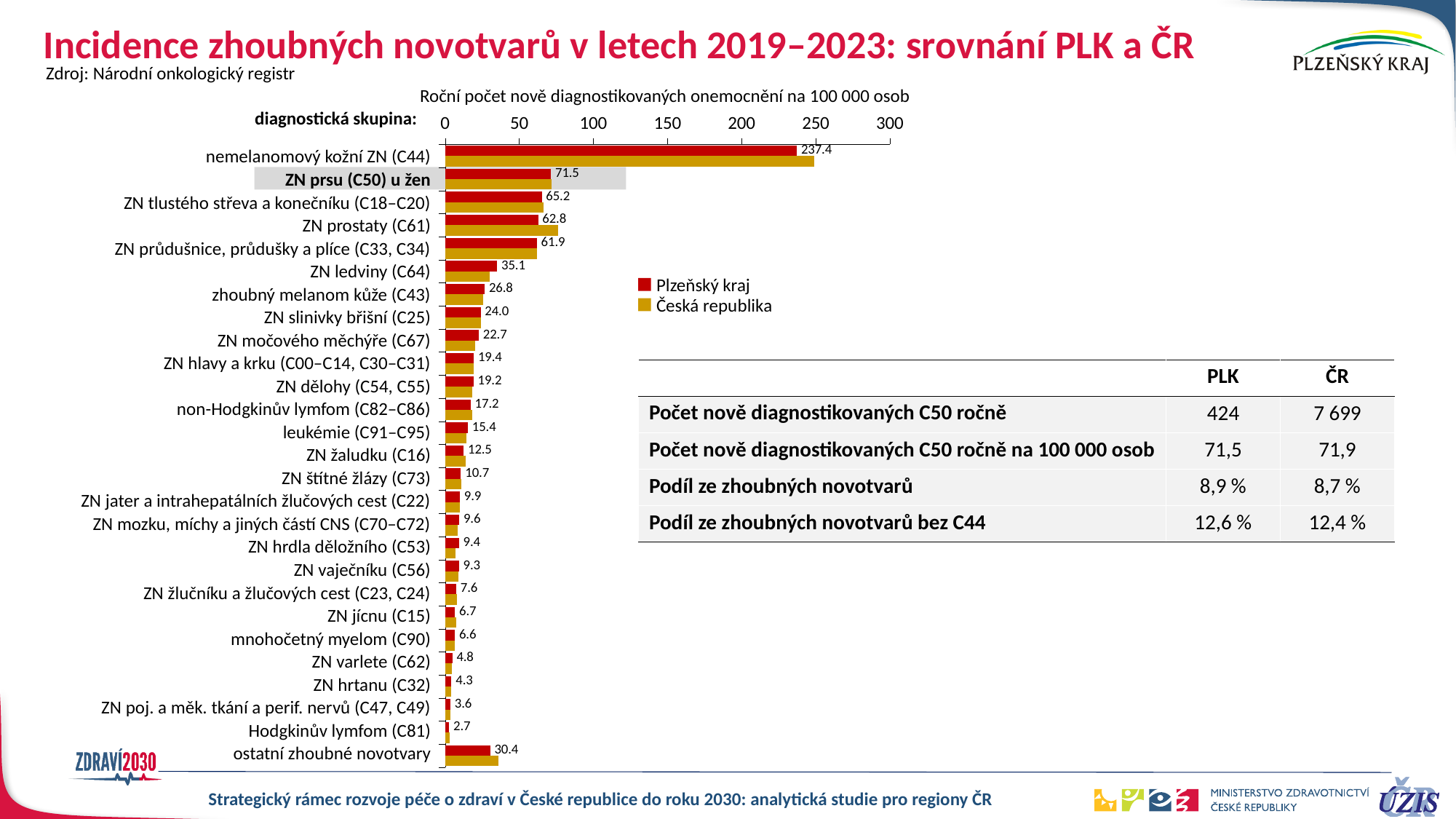
What is the value for Plzeňský kraj for ZN ledviny (C64)? 35.1 Which diagnostic group has the highest value for Plzeňský kraj? nemelanomový kožní ZN (C44) What is the value for Plzeňský kraj for Hodgkinův lymfom (C81)? 2.7 Which has a larger Plzeňský kraj value: ZN ledviny (C64) or zhoubný melanom kůže (C43)? ZN ledviny (C64) Which diagnostic group has the lowest value for Plzeňský kraj? Hodgkinův lymfom (C81) What is the value for Plzeňský kraj for ZN prsu (C50) u žen? 71.5 How many series does the chart legend list? 2 Is the value for Česká republika for nemelanomový kožní ZN (C44) greater or less than 200? greater What is the value for Plzeňský kraj for nemelanomový kožní ZN (C44)? 237.4 How many diagnostic groups are shown in the chart? 27 What is the difference between the Plzeňský kraj values for ZN prsu (C50) u žen and ZN tlustého střeva a konečníku (C18–C20)? 6.3 What kind of chart is shown on the slide? bar chart